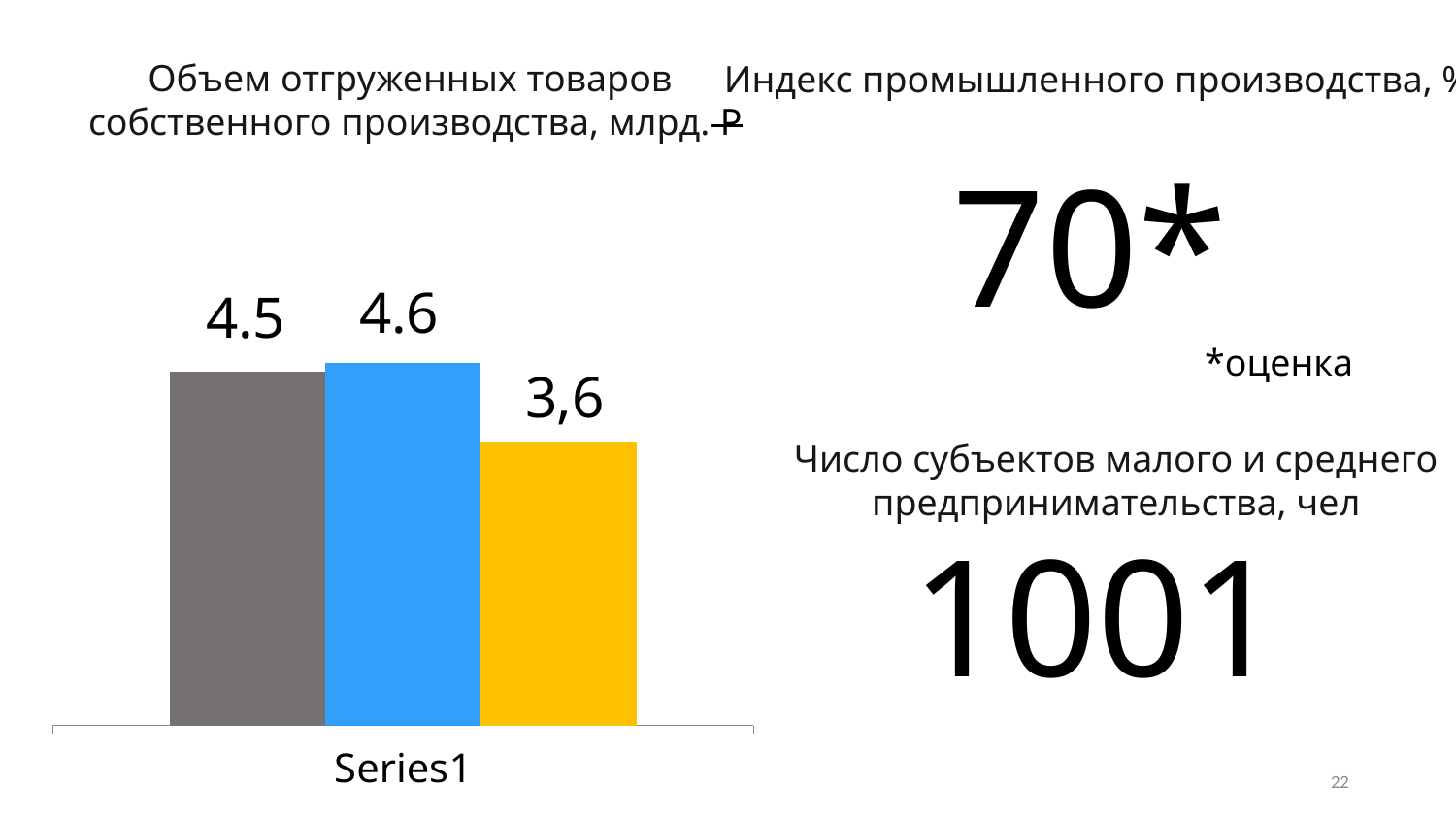
What is the value shown on the blue (middle) bar? 4.6 What is the difference between the gray bar and the yellow bar? 0.9 What is the value shown on the yellow (right) bar? 3,6 What is the value shown on the gray (left) bar? 4.5 Which bar has the highest value? the blue (middle) bar How many bars are plotted in the chart? 3 What kind of chart is shown on the slide? bar chart Which bar has the lowest value? the yellow (right) bar What is the difference between the blue bar and the yellow bar? 1.0 Which is larger, the gray bar or the yellow bar? the gray bar What is the title of the chart? Объем отгруженных товаров собственного производства, млрд. ₽ What category label is shown under the bars on the x axis? Series1